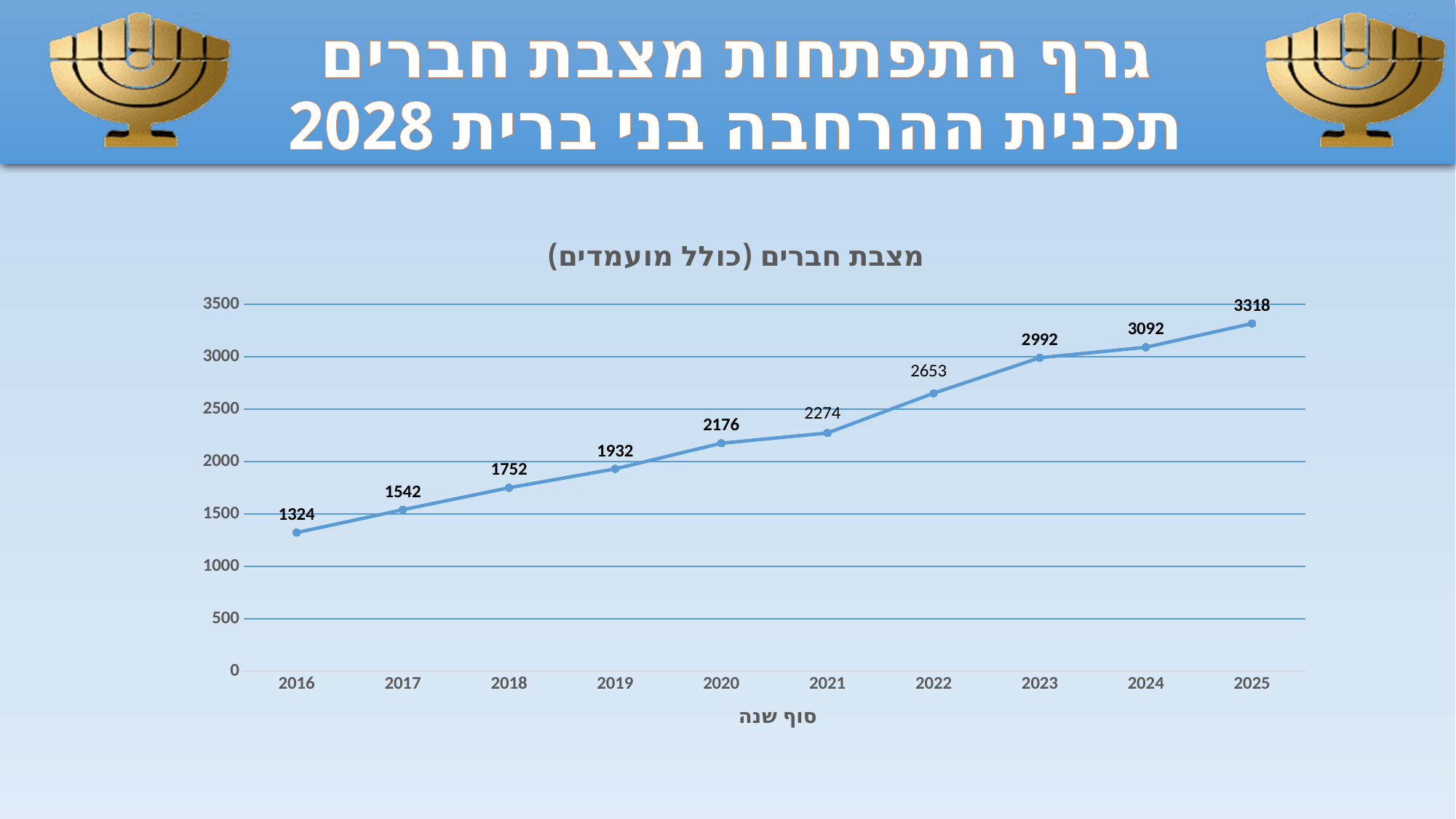
What is the value for 2020? 2176 How many years are plotted on the x axis? 10 Which is larger, the value for 2019 or the value for 2018? 2019 Which year has the highest value? 2025 Which year has the lowest value? 2016 What kind of chart is shown on the slide? line chart What is the difference between the values for 2022 and 2021? 379 What is the value for 2016? 1324 What is the value for 2025? 3318 Is the value for 2023 greater or less than 2500? greater Do the values rise or fall from 2016 to 2025? rise What is the difference between the values for 2025 and 2016? 1994